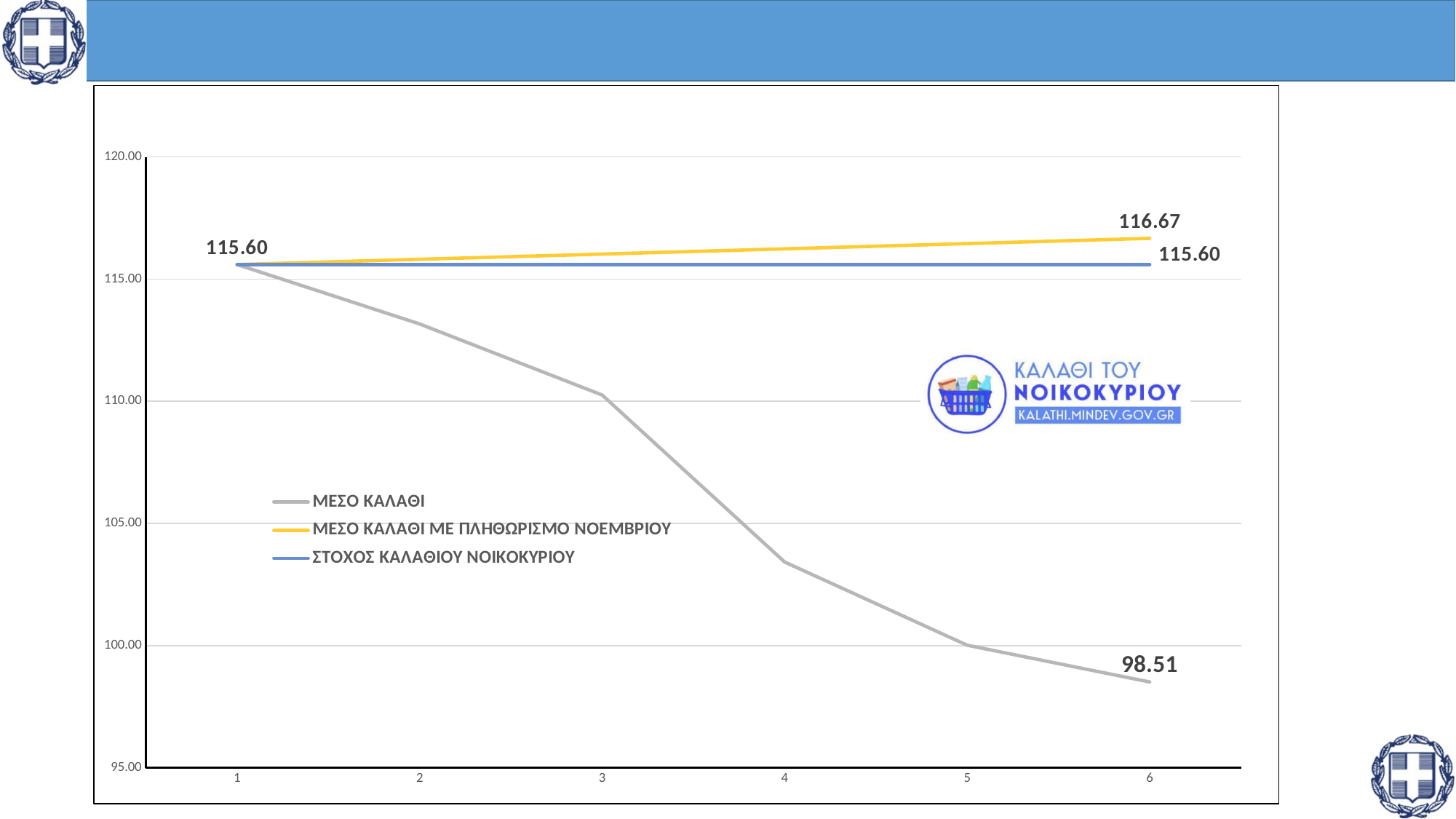
What is the difference between ΜΕΣΟ ΚΑΛΑΘΙ ΜΕ ΠΛΗΘΩΡΙΣΜΟ ΝΟΕΜΒΡΙΟΥ and ΣΤΟΧΟΣ ΚΑΛΑΘΙΟΥ ΝΟΙΚΟΚΥΡΙΟΥ at point 6? 1.07 How many series does the legend list? 3 What is the value of ΜΕΣΟ ΚΑΛΑΘΙ ΜΕ ΠΛΗΘΩΡΙΣΜΟ ΝΟΕΜΒΡΙΟΥ at point 6? 116.67 What colour is the ΣΤΟΧΟΣ ΚΑΛΑΘΙΟΥ ΝΟΙΚΟΚΥΡΙΟΥ line? blue Which series has the lowest value at point 6? ΜΕΣΟ ΚΑΛΑΘΙ What is the difference between ΜΕΣΟ ΚΑΛΑΘΙ ΜΕ ΠΛΗΘΩΡΙΣΜΟ ΝΟΕΜΒΡΙΟΥ and ΜΕΣΟ ΚΑΛΑΘΙ at point 6? 18.16 What is the value of ΣΤΟΧΟΣ ΚΑΛΑΘΙΟΥ ΝΟΙΚΟΚΥΡΙΟΥ at point 6? 115.60 What kind of chart is shown on the slide? line chart Does the ΜΕΣΟ ΚΑΛΑΘΙ series rise or fall from point 1 to point 6? fall How many points are there along the x axis? 6 Is the value of ΜΕΣΟ ΚΑΛΑΘΙ at point 4 greater or less than 105.00? less What is the value of ΜΕΣΟ ΚΑΛΑΘΙ at point 6? 98.51